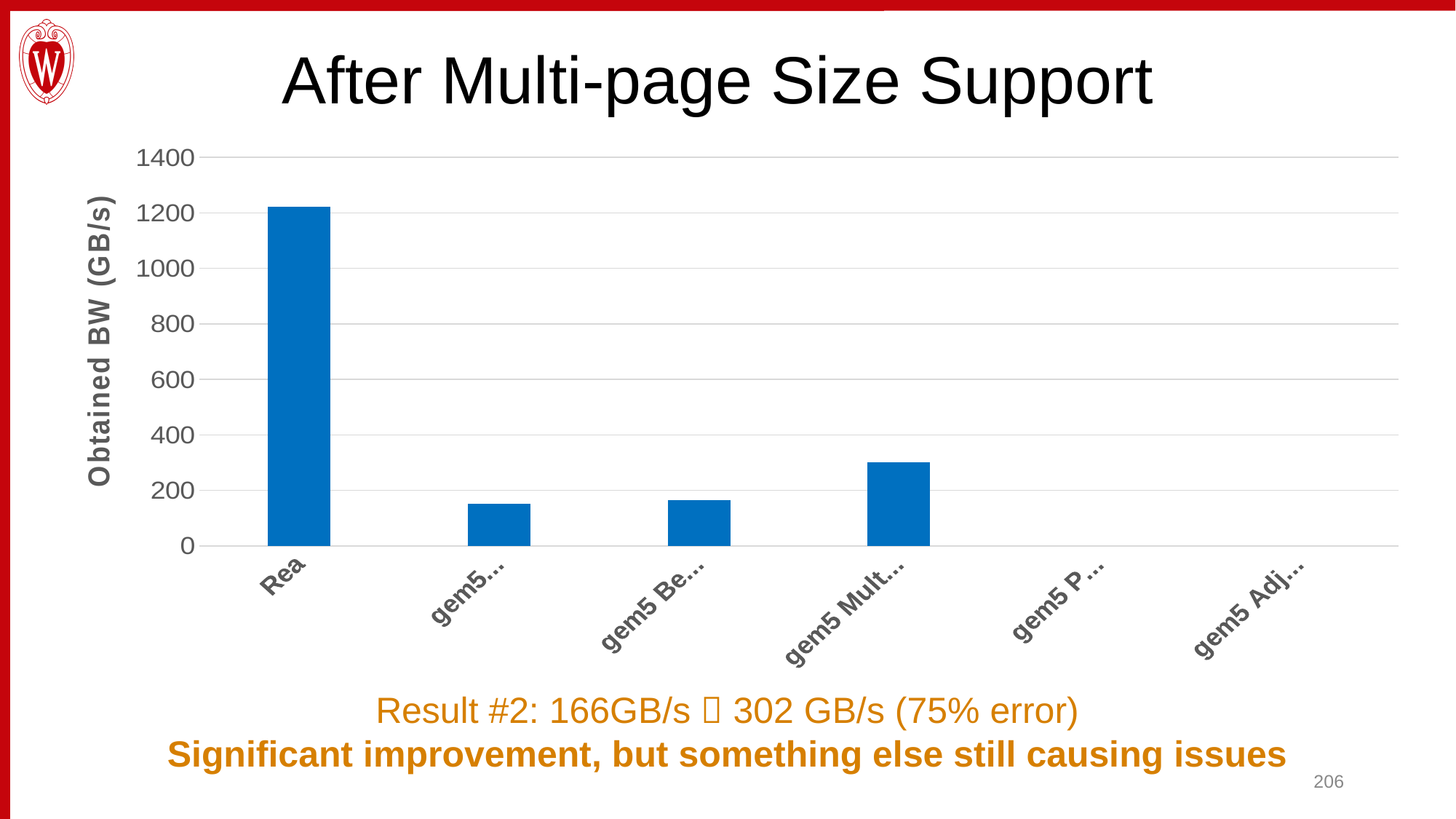
Is the value of the first bar (Rea) greater or less than 1000? greater Which is larger: the bar for gem5 Mult… or the bar for gem5 Be…? gem5 Mult… Is the value of the second bar from the left greater or less than 200? less How many category labels are shown along the x axis of the chart? 6 Is the value of the fourth bar from the left (gem5 Mult…) greater or less than 200? greater What is the highest tick value shown on the vertical axis of the chart? 1400 What is the label of the vertical axis of the chart? Obtained BW (GB/s) How many bars with a visible height are plotted in the chart? 4 What kind of chart is shown on the slide? bar chart Which category has the tallest bar in the chart? Rea